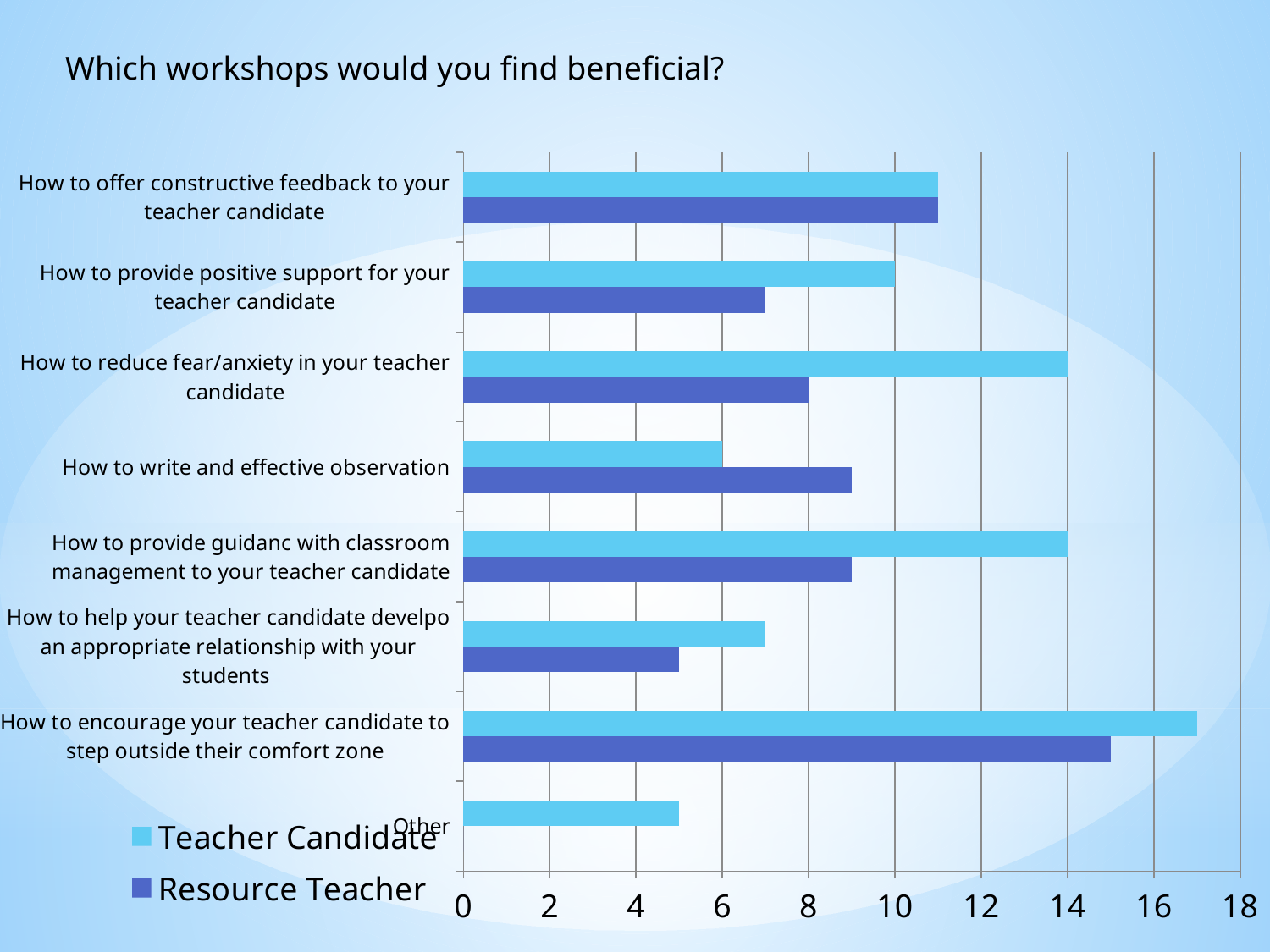
What is the difference between the Teacher Candidate and Resource Teacher values for 'How to reduce fear/anxiety in your teacher candidate'? 6 For 'How to write and effective observation', which series has the larger value, Teacher Candidate or Resource Teacher? Resource Teacher How many series does the legend list? 2 Is the Teacher Candidate value for 'How to encourage your teacher candidate to step outside their comfort zone' greater or less than 16? greater Which workshop has the lowest Resource Teacher value? Other What is the Teacher Candidate value for 'How to reduce fear/anxiety in your teacher candidate'? 14 What is the Resource Teacher value for 'How to reduce fear/anxiety in your teacher candidate'? 8 What kind of chart is shown on the slide? bar chart How many workshop categories are shown on the chart? 8 What is the Teacher Candidate value for 'How to provide positive support for your teacher candidate'? 10 What is the Teacher Candidate value for 'How to write and effective observation'? 6 Which workshop has the highest Teacher Candidate value? How to encourage your teacher candidate to step outside their comfort zone